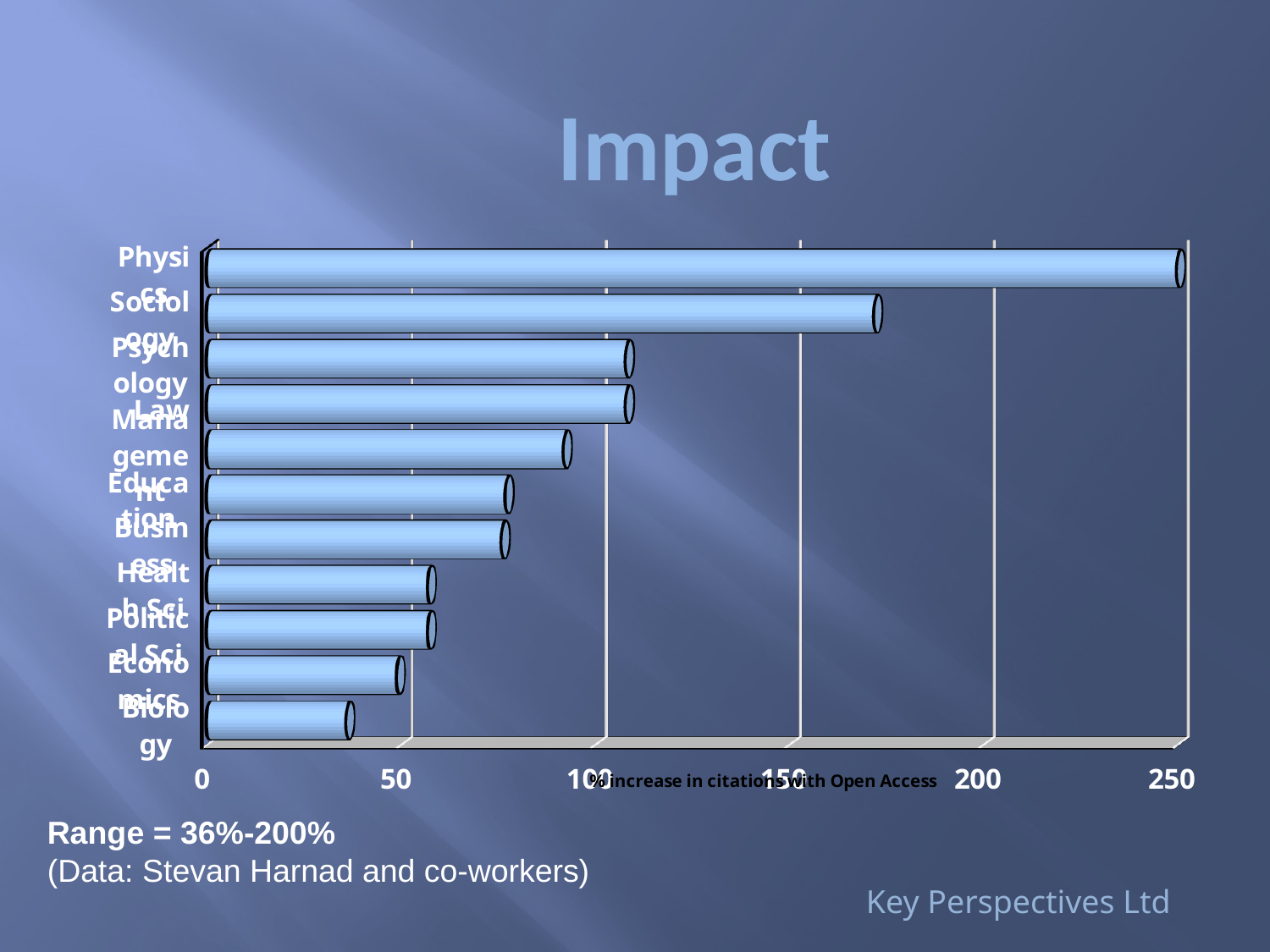
Which has the larger value, Economics or Education? Education What is the label on the horizontal axis of the chart? % increase in citations with Open Access Which has the larger value, Sociology or Law? Sociology Which category has the lowest value in the chart? Biology What kind of chart is shown on the slide? bar chart Is the value for Management greater or less than 100? less Is the value for Physics greater or less than 200? greater How many categories (bars) does the chart show? 11 Which category has the highest value in the chart? Physics Is the value for Biology greater or less than 50? less What is the title of the slide containing the chart? Impact